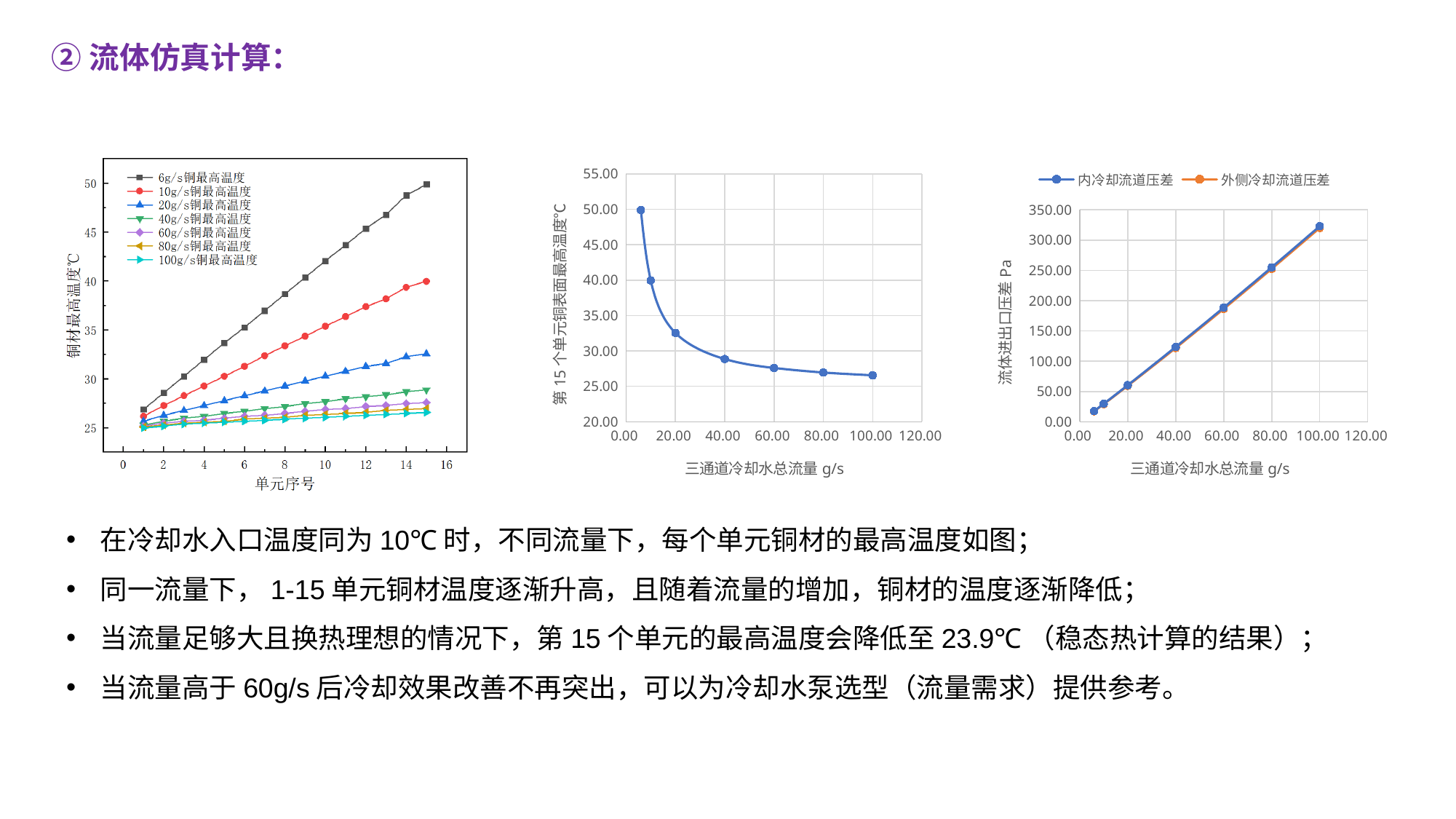
In the right chart, how many series does the legend list? 2 In the left chart, at 单元序号 15, which is larger: 10g/s铜最高温度 or 20g/s铜最高温度? 10g/s铜最高温度 In the left chart, how many series does the legend list? 7 In the right chart, do the values of 内冷却流道压差 rise or fall as 三通道冷却水总流量 increases? rise In the middle chart, how many data points are plotted? 7 In the right chart, is the value of 内冷却流道压差 at 100.00 g/s greater or less than 300.00? greater In the middle chart, do the values rise or fall as 三通道冷却水总流量 increases? fall In the middle chart, is the value at 100.00 g/s greater or less than 30.00? less What kind of chart is the left chart (铜材最高温度 vs 单元序号)? line chart In the left chart, is the value of 6g/s铜最高温度 at 单元序号 15 greater or less than 45? greater In the left chart, do the values of the 6g/s铜最高温度 series rise or fall as 单元序号 increases? rise In the left chart, which series has the highest temperature at 单元序号 15? 6g/s铜最高温度